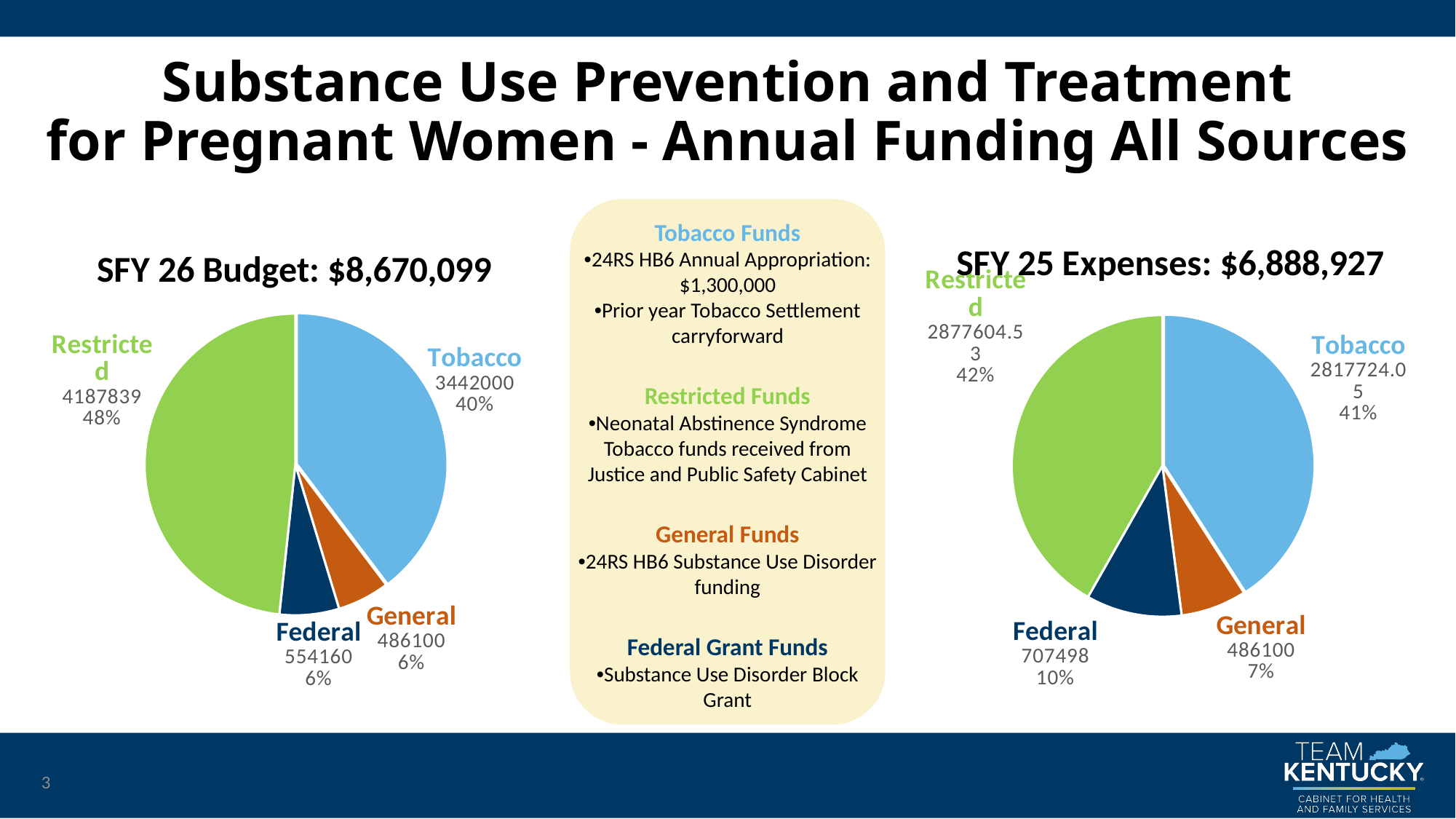
In the SFY 25 Expenses pie chart, what is the difference between the Federal and General values? 221398 What kind of chart is the SFY 26 Budget chart? Pie chart What colour is the Restricted slice in the SFY 26 Budget pie chart? Green In the SFY 25 Expenses pie chart, what share of the pie is Tobacco? 41% How many categories does the SFY 25 Expenses pie chart show? 4 In the SFY 26 Budget pie chart, which category is the largest? Restricted In the SFY 25 Expenses pie chart, what is the value for Federal? 707498 In the SFY 25 Expenses pie chart, which is larger, Federal or General? Federal In the SFY 26 Budget pie chart, what is the difference between the Federal and General values? 68060 In the SFY 25 Expenses pie chart, which category is the smallest? General In the SFY 26 Budget pie chart, what share of the pie is Restricted? 48% In the SFY 26 Budget pie chart, what is the value for Tobacco? 3442000